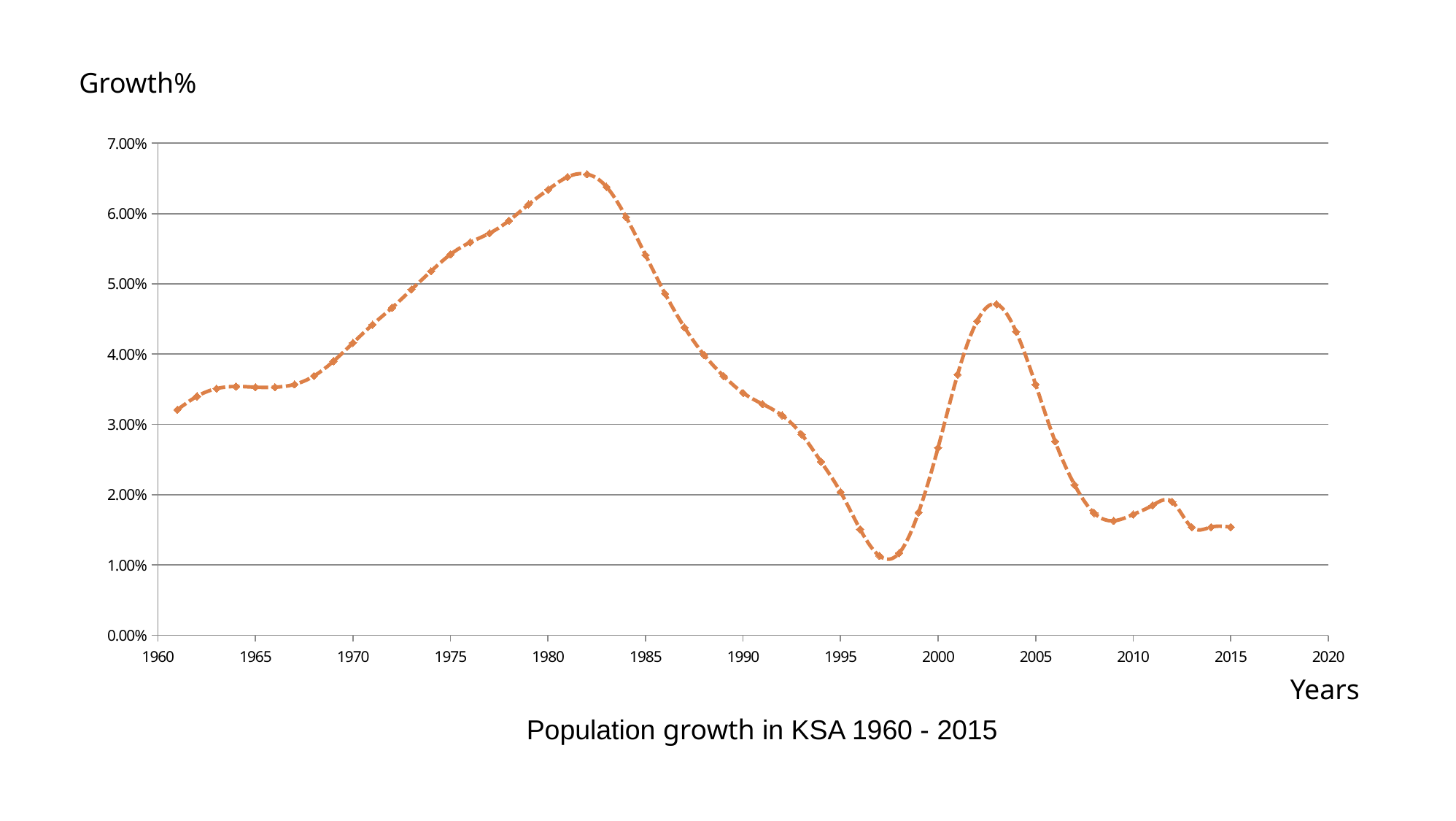
Is the highest value on the line greater or less than 6.00%? greater Which year has the larger growth value, 1982 or 2003? 1982 Does the growth rate rise or fall between 1982 and 1997? fall Is the value for 2003 greater or less than 4.00%? greater Is the value for 1961 greater or less than 3.00%? greater What is the title of the chart? Population growth in KSA 1960 - 2015 What label is shown on the vertical axis of the chart? Growth% Which year has the larger growth value, 1961 or 2015? 1961 What kind of chart is shown on the slide? line chart